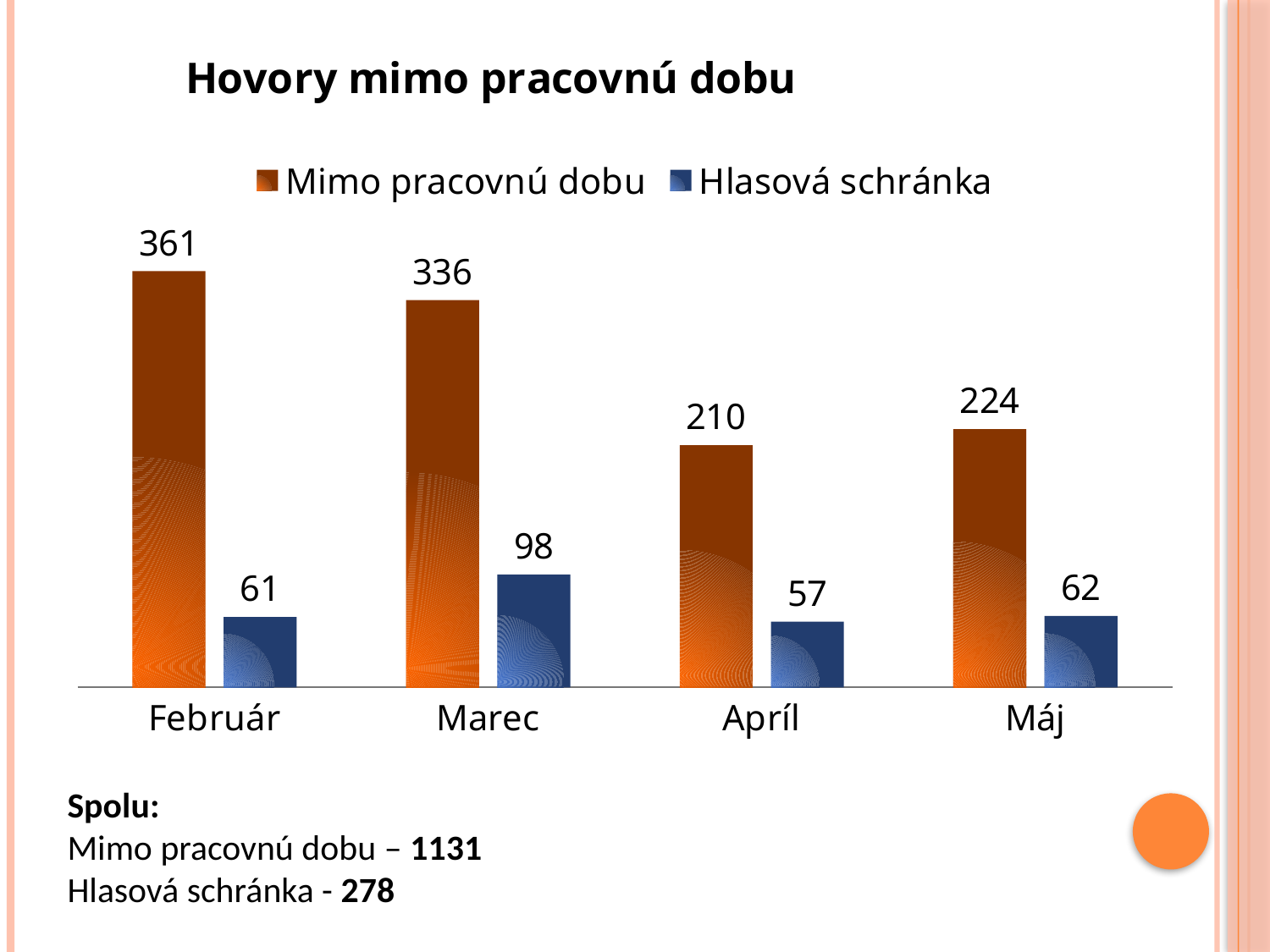
Which is larger: Mimo pracovnú dobu in Máj or Mimo pracovnú dobu in Apríl? Máj What is the difference between the Mimo pracovnú dobu values for Február and Marec? 25 What is the title of the chart? Hovory mimo pracovnú dobu What is the value for Mimo pracovnú dobu in Apríl? 210 How many series does the legend list? 2 How many months are shown on the x axis? 4 What is the value for Mimo pracovnú dobu in Február? 361 What kind of chart is shown on the slide? Bar chart Which month has the highest value for Mimo pracovnú dobu? Február Which month has the lowest value for Hlasová schránka? Apríl What is the value for Hlasová schránka in Marec? 98 What is the value for Hlasová schránka in Máj? 62